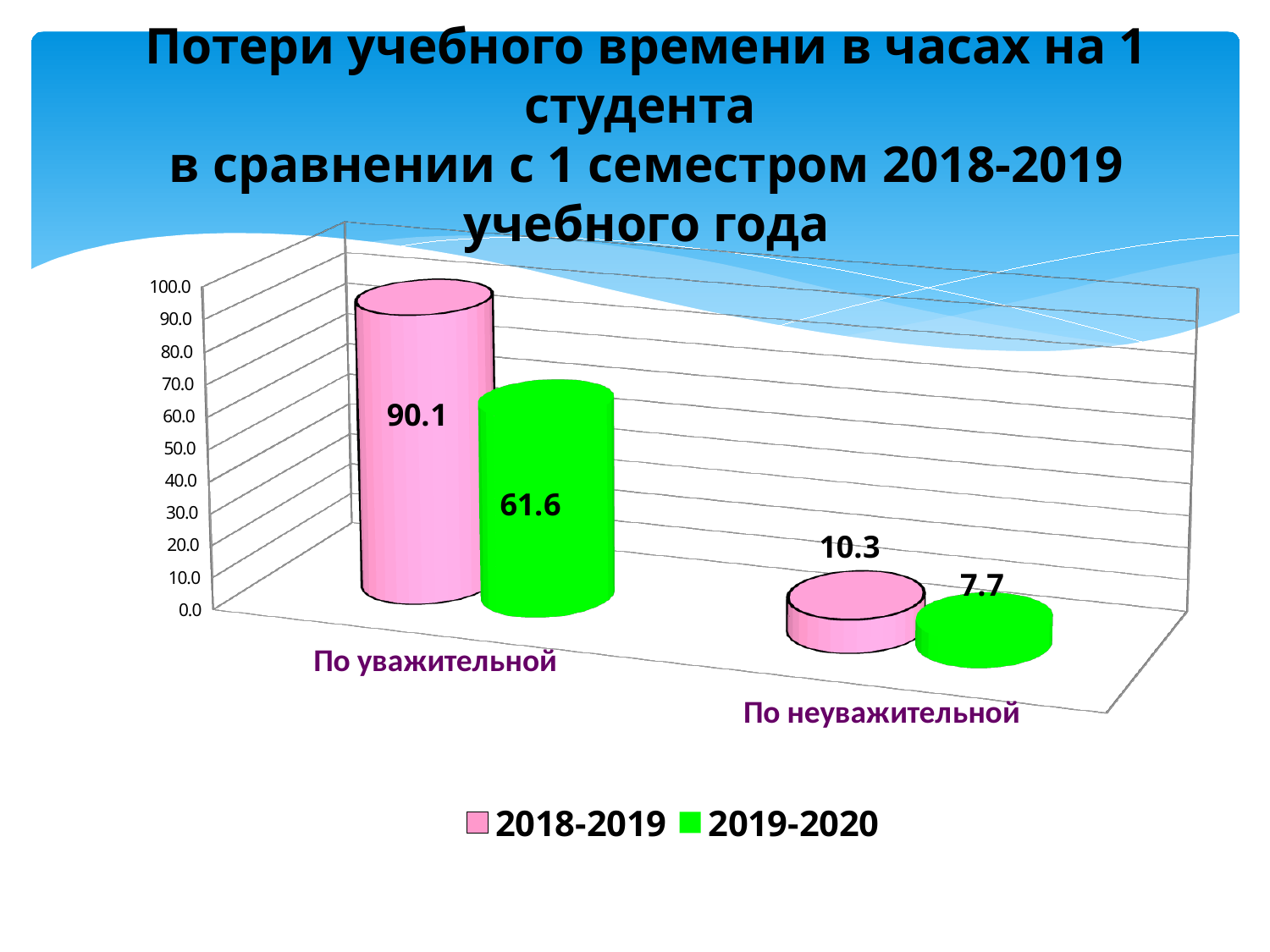
Which category has the lowest value for the 2019-2020 series? По неуважительной How many categories are shown on the x axis? 2 Which category has the highest value for the 2018-2019 series? По уважительной What is the value for 2019-2020 in the 'По уважительной' category? 61.6 What is the value for 2018-2019 in the 'По уважительной' category? 90.1 How many series does the legend list? 2 What kind of chart is shown on the slide? Bar chart Which is larger in the 'По неуважительной' category: the 2018-2019 value or the 2019-2020 value? 2018-2019 What is the value for 2018-2019 in the 'По неуважительной' category? 10.3 What is the value for 2019-2020 in the 'По неуважительной' category? 7.7 What is the difference between the 2018-2019 and 2019-2020 values in the 'По уважительной' category? 28.5 What is the difference between the 2018-2019 and 2019-2020 values in the 'По неуважительной' category? 2.6